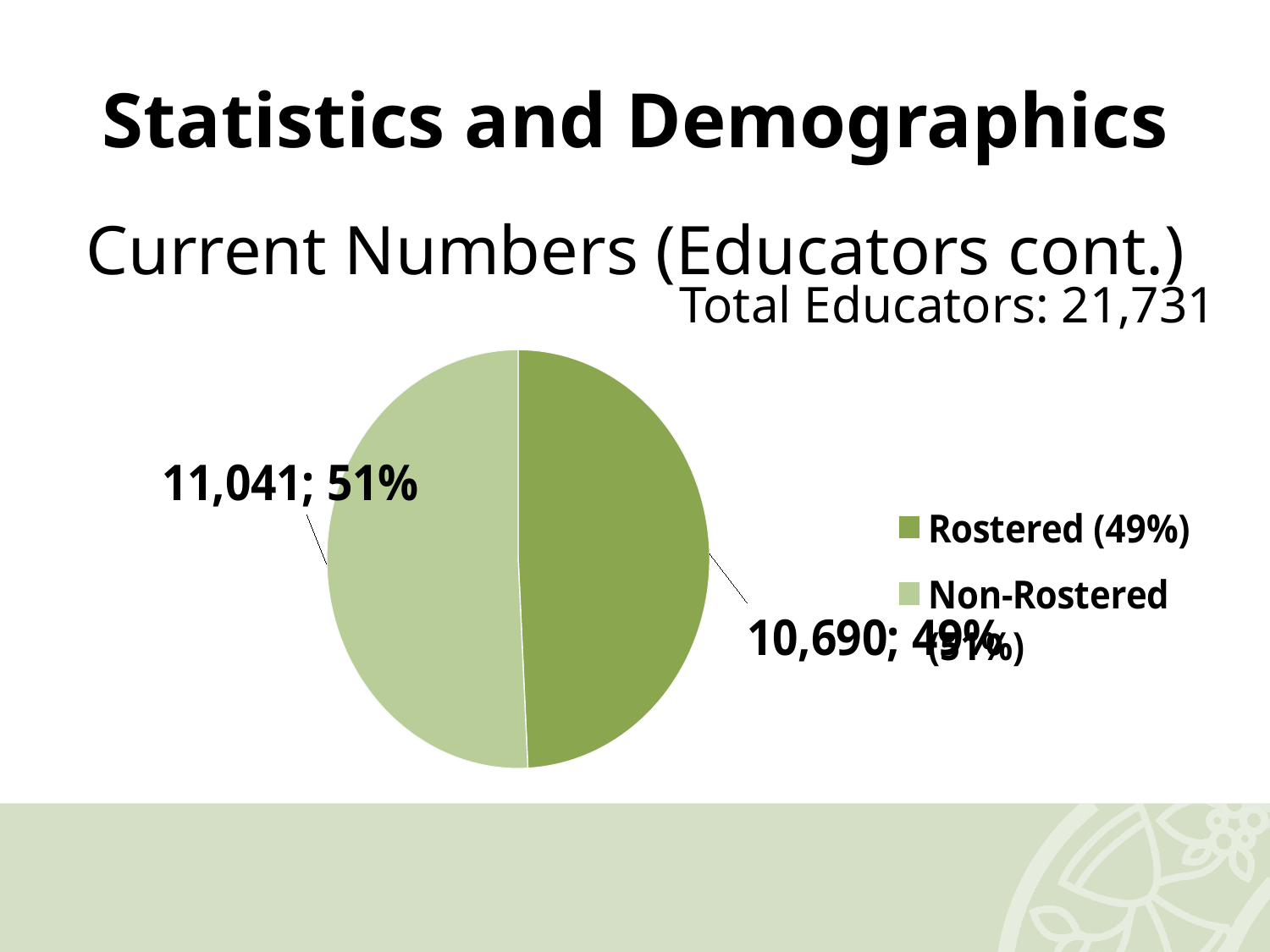
What share of the pie does the Non-Rostered slice represent? 51% What is the value shown for the Rostered slice? 10,690 Which category has the smallest slice? Rostered Which slice is larger, Rostered or Non-Rostered? Non-Rostered How many slices does the pie chart have? 2 What is the difference between the Non-Rostered and Rostered values? 351 How many entries does the legend list? 2 What share of the pie does the Rostered slice represent? 49% Which legend entry is shown in the darker green colour? Rostered (49%) What is the total number of educators stated on the slide? 21,731 What is the value shown for the Non-Rostered slice? 11,041 What kind of chart is shown on the slide? pie chart